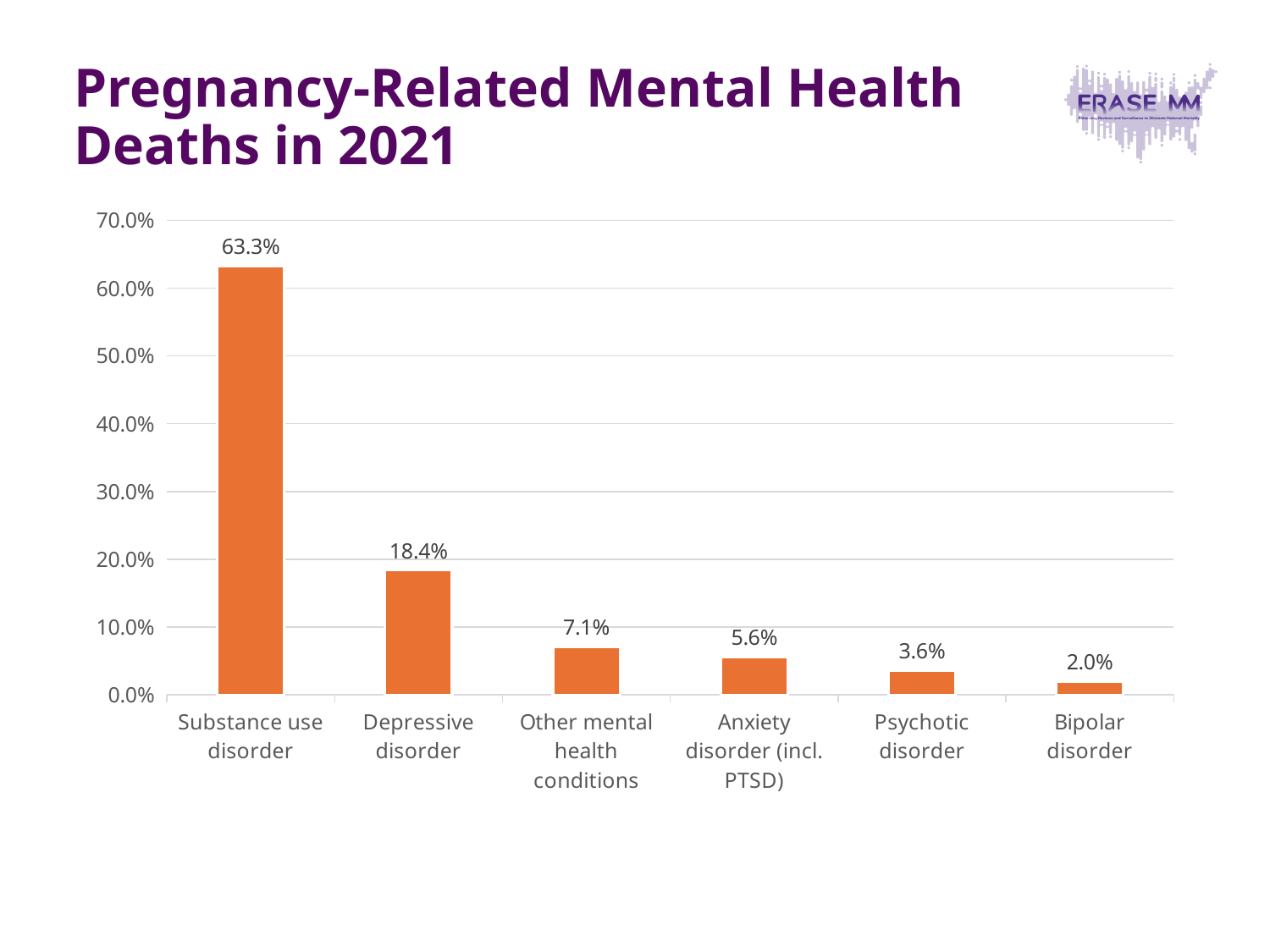
What is the value for Anxiety disorder (incl. PTSD)? 5.6% What is the value for Bipolar disorder? 2.0% What is the value for Depressive disorder? 18.4% What is the difference between the values for Substance use disorder and Depressive disorder? 44.9% Which is larger, the value for Other mental health conditions or the value for Anxiety disorder (incl. PTSD)? Other mental health conditions How many categories are shown on the chart? 6 What is the value for Substance use disorder? 63.3% Which category has the highest value? Substance use disorder Which category has the lowest value? Bipolar disorder What kind of chart is shown on the slide? Bar chart What is the difference between the values for Other mental health conditions and Psychotic disorder? 3.5% Is the value for Depressive disorder greater or less than 20.0%? less